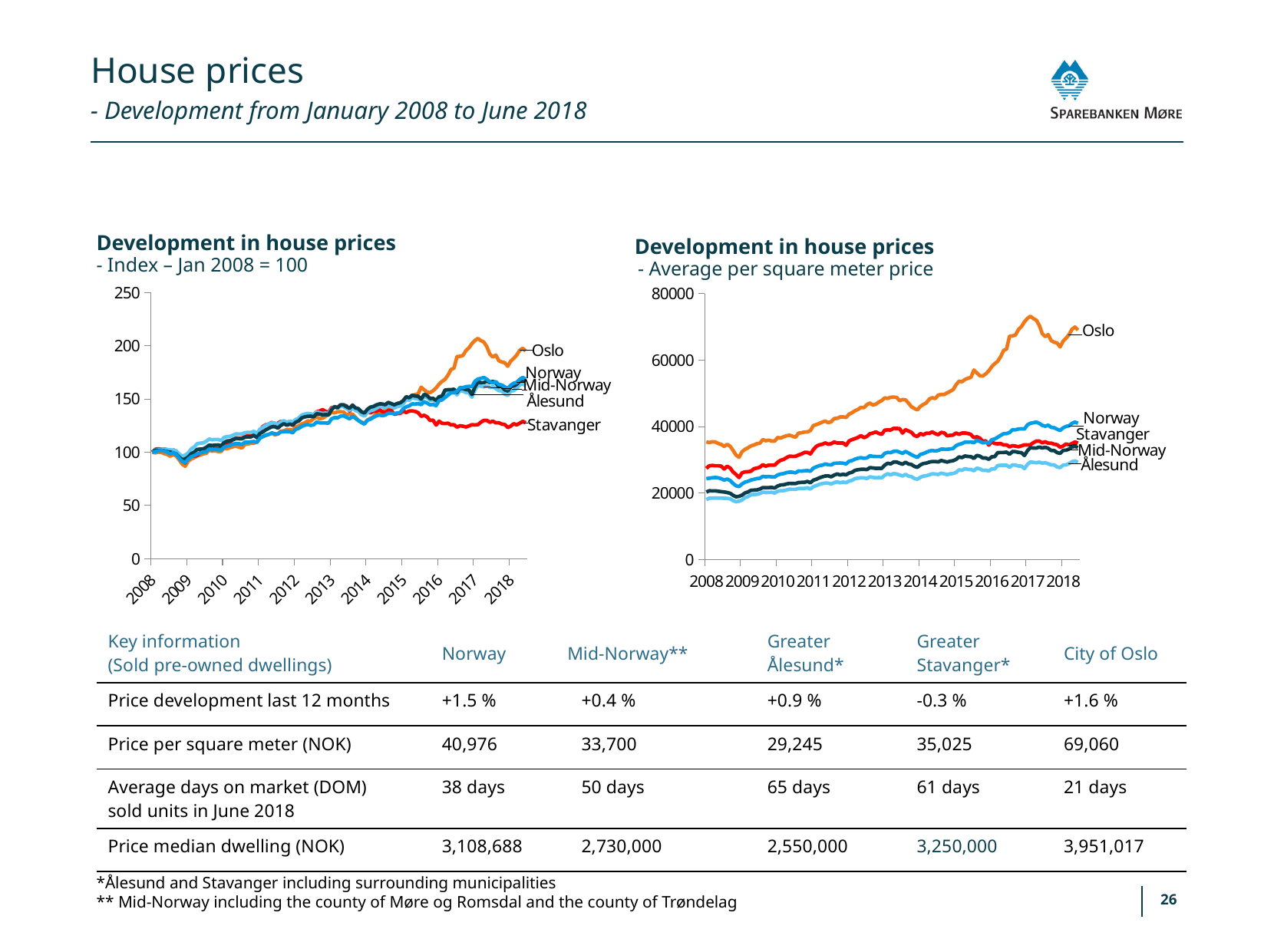
In the left chart (Index – Jan 2008 = 100), how many series are plotted? 5 In the right chart (Average per square meter price), is the value for Oslo at the end of the period greater or less than 60000? greater In the right chart (Average per square meter price), is the value for Ålesund at the end of the period greater or less than 40000? less What kind of chart is the left chart, 'Development in house prices - Index – Jan 2008 = 100'? Line chart In the right chart (Average per square meter price), does the Oslo series rise or fall overall from 2008 to 2018? Rise In the right chart (Average per square meter price), which series has the lowest value at the end of the period in 2018? Ålesund In the left chart (Index – Jan 2008 = 100), which series has the highest value at the end of the period in 2018? Oslo In the left chart (Index – Jan 2008 = 100), which series has the lowest value at the end of the period in 2018? Stavanger In the right chart (Average per square meter price), how many series are plotted? 5 In the left chart (Index – Jan 2008 = 100), is the value for Stavanger at the end of the period greater or less than 150? less What is the index base stated in the subtitle of the left chart? Jan 2008 = 100 What kind of chart is the right chart, 'Development in house prices - Average per square meter price'? Line chart